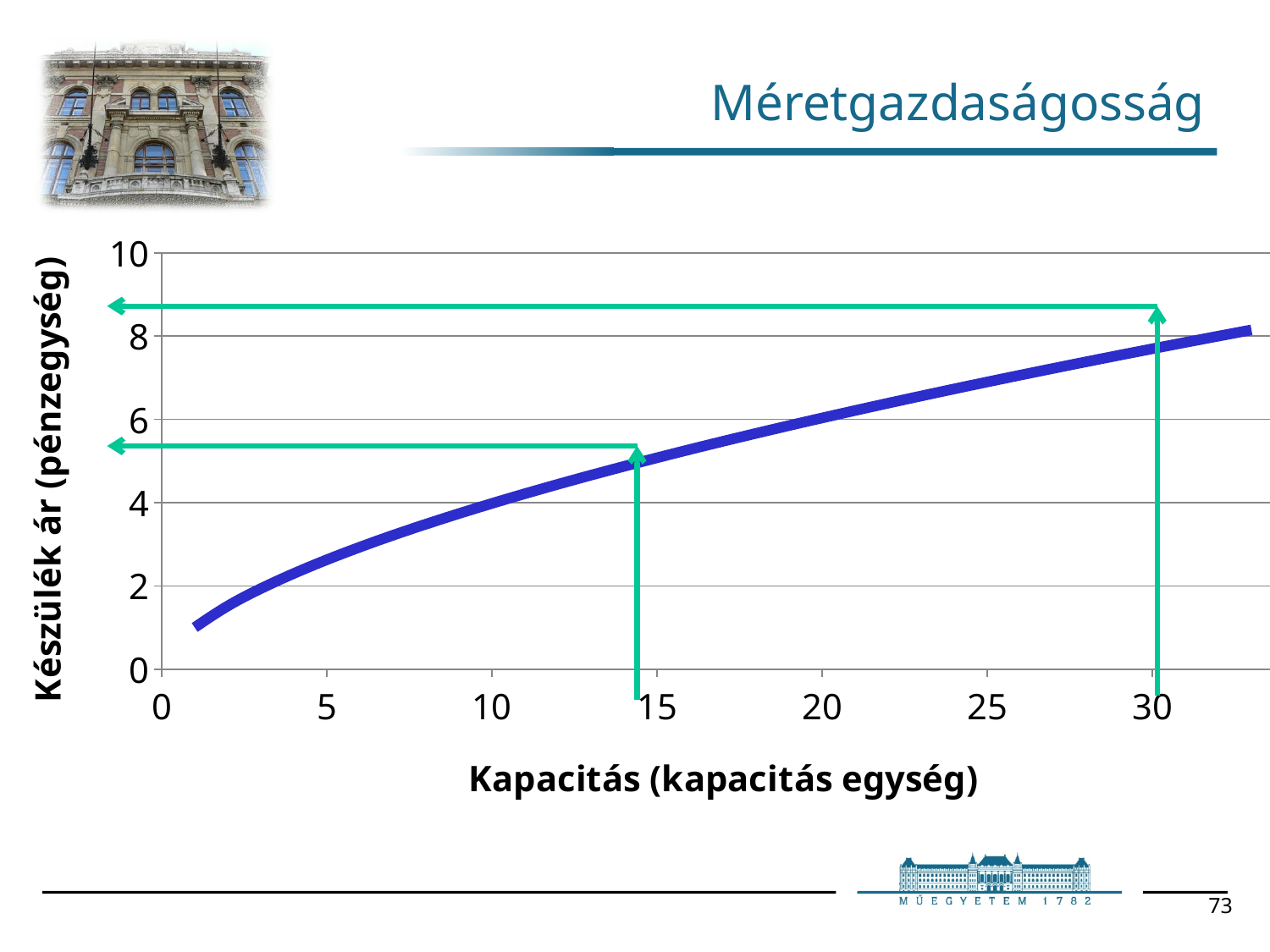
Is the value of the curve at Kapacitás 30 greater or less than 6? greater How many data series are plotted on the chart? 1 Is the value of the curve at Kapacitás 15 greater or less than 4? greater Is the value of the curve at Kapacitás 5 greater or less than 4? less What is the title of the slide containing the chart? Méretgazdaságosság What is the label of the x axis of the chart? Kapacitás (kapacitás egység) What is the highest tick value shown on the y axis of the chart? 10 What kind of chart is shown on the slide? line chart Does the plotted curve rise or fall as Kapacitás increases along the x axis? rise